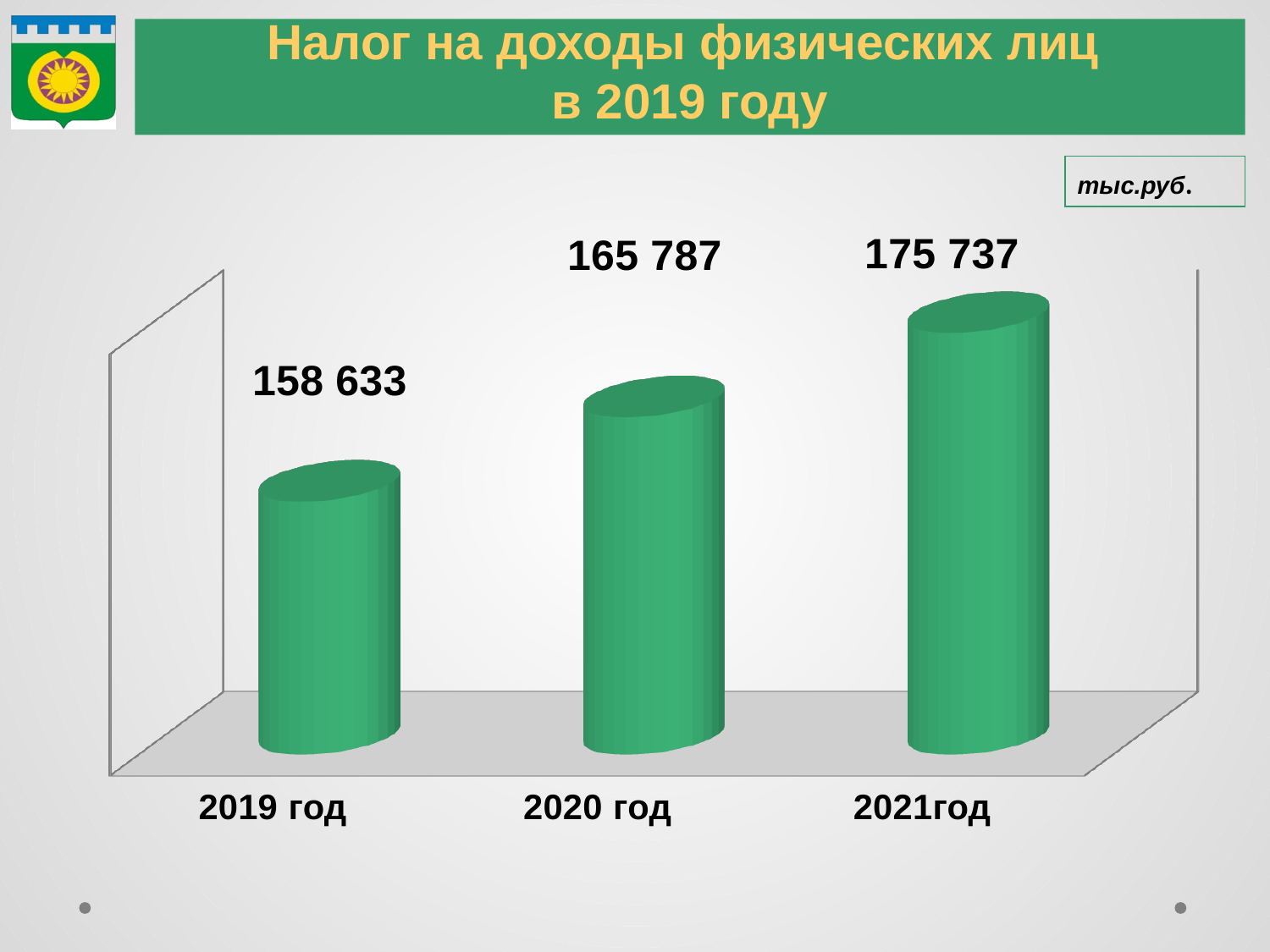
Which is larger, the value for 2020 год or the value for 2021год? 2021год What is the difference between the values for 2021год and 2019 год? 17 104 What is the value for 2021год? 175 737 Which year has the lowest value? 2019 год What unit is indicated for the chart values? тыс.руб. How many categories are shown in the chart? 3 What kind of chart is shown on the slide? bar chart What is the value for 2020 год? 165 787 Do the values rise or fall from 2019 год to 2021год? rise What is the value for 2019 год? 158 633 Which year has the highest value? 2021год What is the difference between the values for 2020 год and 2019 год? 7 154